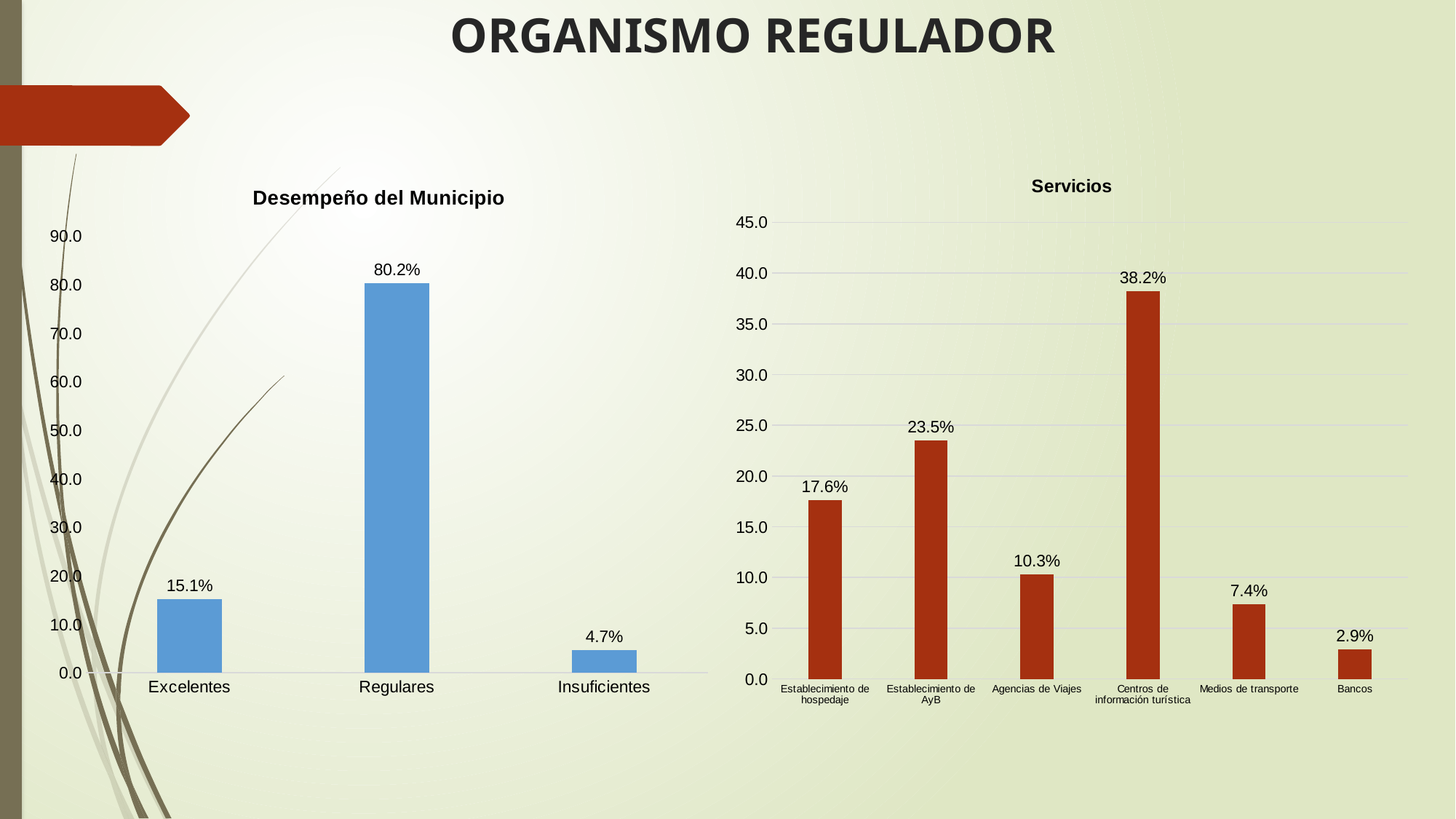
In the 'Desempeño del Municipio' chart, what is the value for Regulares? 80.2% In the 'Desempeño del Municipio' chart, which category has the lowest value? Insuficientes In the 'Servicios' chart, which is larger: Establecimiento de hospedaje or Establecimiento de AyB? Establecimiento de AyB In the 'Desempeño del Municipio' chart, how many categories are shown? 3 In the 'Servicios' chart, which category has the lowest value? Bancos In the 'Servicios' chart, what is the value for Agencias de Viajes? 10.3% What kind of chart is the 'Servicios' chart? bar chart In the 'Desempeño del Municipio' chart, what is the difference between Regulares and Excelentes? 65.1% In the 'Servicios' chart, which category has the highest value? Centros de información turística In the 'Servicios' chart, how many categories are shown? 6 In the 'Servicios' chart, what is the difference between Centros de información turística and Medios de transporte? 30.8% What colour are the bars in the 'Servicios' chart? red